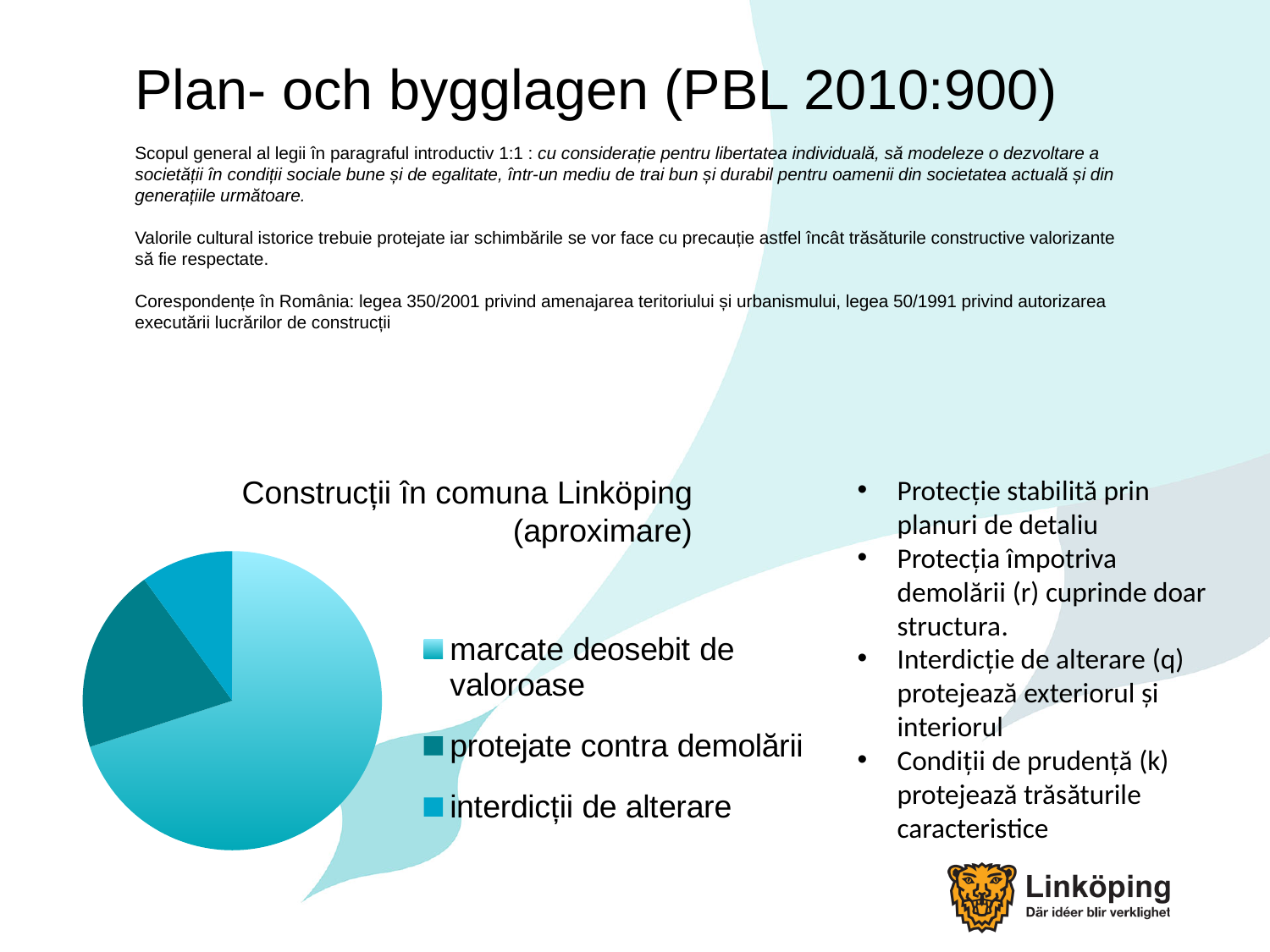
Which category has the largest slice in the pie chart? marcate deosebit de valoroase How many slices does the pie chart have? 3 Which category has the smallest slice in the pie chart? interdicții de alterare What is the title of the pie chart? Construcții în comuna Linköping (aproximare) Which legend entry is listed first in the pie chart's legend? marcate deosebit de valoroase How many entries does the legend of the pie chart list? 3 Which slice is larger: 'marcate deosebit de valoroase' or 'protejate contra demolării'? marcate deosebit de valoroase Which slice is larger: 'protejate contra demolării' or 'interdicții de alterare'? protejate contra demolării What kind of chart is shown on the slide? pie chart